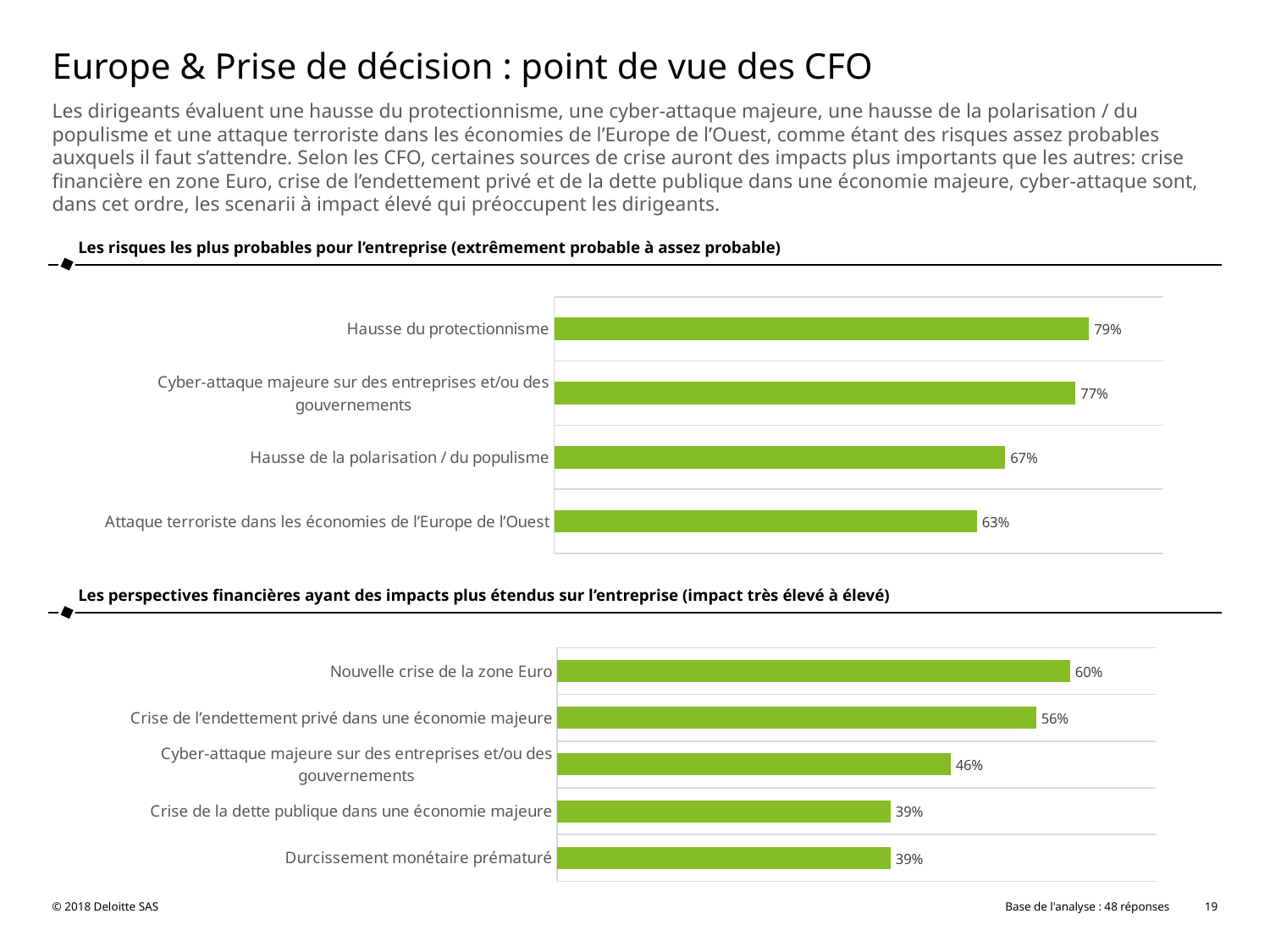
In the top chart (Les risques les plus probables pour l'entreprise), which category has the lowest value? Attaque terroriste dans les économies de l'Europe de l'Ouest In the bottom chart (Les perspectives financières ayant des impacts plus étendus sur l'entreprise), what is the value for Cyber-attaque majeure sur des entreprises et/ou des gouvernements? 46% In the top chart (Les risques les plus probables pour l'entreprise), what is the difference between Hausse du protectionnisme and Hausse de la polarisation / du populisme? 12 percentage points In the top chart (Les risques les plus probables pour l'entreprise), how many categories are shown? 4 In the bottom chart (Les perspectives financières ayant des impacts plus étendus sur l'entreprise), which is larger: Crise de l'endettement privé dans une économie majeure or Crise de la dette publique dans une économie majeure? Crise de l'endettement privé dans une économie majeure What colour are the bars in the bottom chart (Les perspectives financières ayant des impacts plus étendus sur l'entreprise)? Green In the bottom chart (Les perspectives financières ayant des impacts plus étendus sur l'entreprise), what is the difference between Nouvelle crise de la zone Euro and Durcissement monétaire prématuré? 21 percentage points In the top chart (Les risques les plus probables pour l'entreprise), what is the value for Hausse du protectionnisme? 79% In the bottom chart (Les perspectives financières ayant des impacts plus étendus sur l'entreprise), what is the value for Nouvelle crise de la zone Euro? 60% In the bottom chart (Les perspectives financières ayant des impacts plus étendus sur l'entreprise), how many categories are shown? 5 What type of chart is the top chart (Les risques les plus probables pour l'entreprise)? Bar chart In the bottom chart (Les perspectives financières ayant des impacts plus étendus sur l'entreprise), which category has the highest value? Nouvelle crise de la zone Euro